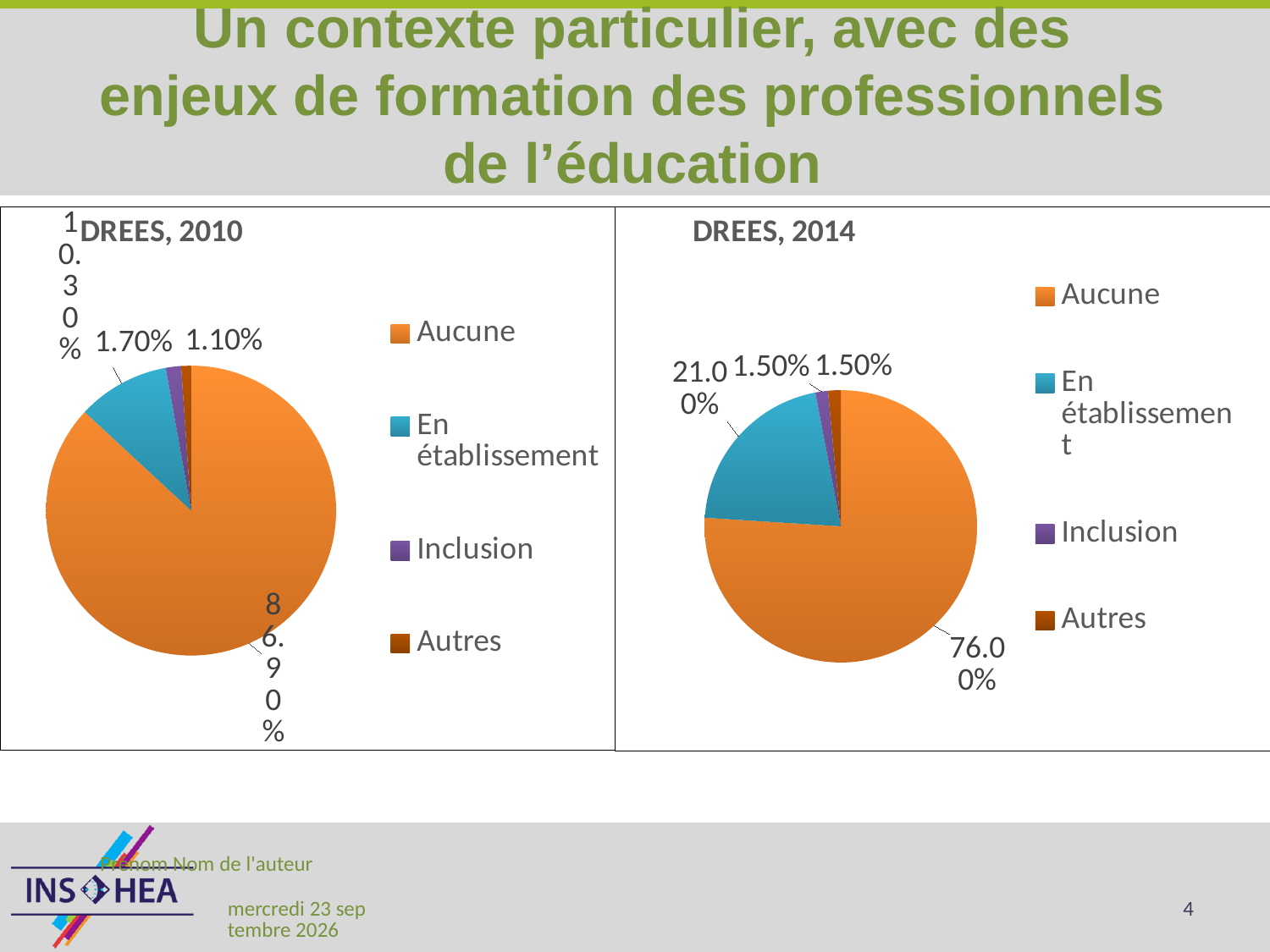
Which is larger: En établissement in the DREES, 2010 chart or En établissement in the DREES, 2014 chart? DREES, 2014 What is the difference between the Aucune values in the DREES, 2010 chart and the DREES, 2014 chart? 10.90% In the DREES, 2014 chart, which category has the largest share? Aucune In the DREES, 2010 chart, what is the difference between Aucune and En établissement? 76.60% What type of chart is the DREES, 2010 chart? Pie chart In the DREES, 2014 chart, what is the value for Aucune? 76.00% In the DREES, 2010 chart, which category has the smallest share? Autres In the DREES, 2010 chart, what is the value for Aucune? 86.90% In the DREES, 2010 chart, what is the value for Inclusion? 1.70% In the DREES, 2014 chart, what colour is the Inclusion slice? Purple How many categories does the DREES, 2014 chart show? 4 In the DREES, 2014 chart, what is the value for En établissement? 21.00%